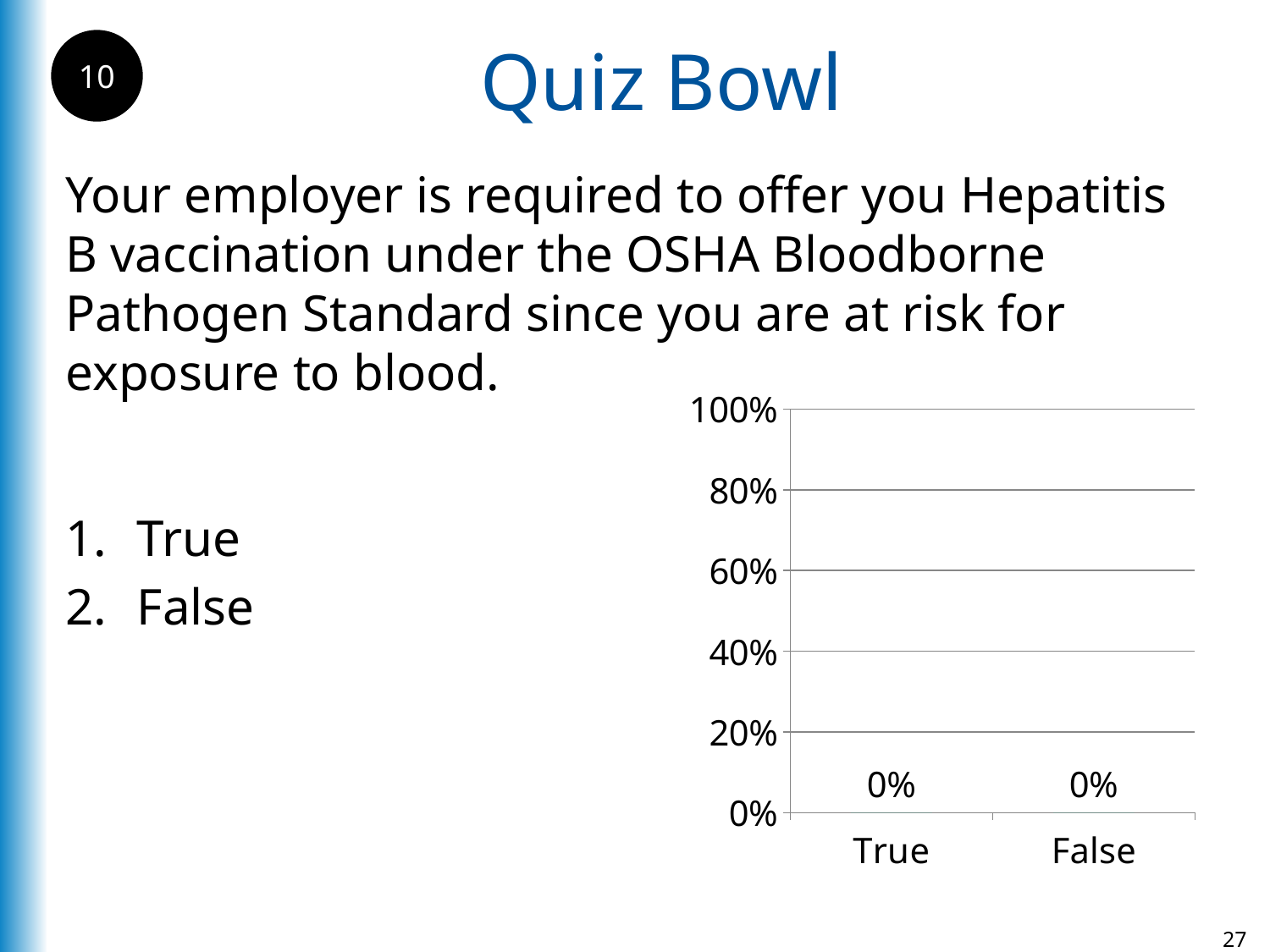
What is the value shown for True? 0% What are the category labels on the x axis of the chart? True, False Is the value for False greater or less than 40%? less What kind of chart is shown on the slide? bar chart What is the difference between the values for True and False? 0% How many categories are shown on the x axis of the chart? 2 What is the highest value labelled on the y axis of the chart? 100% What is the value shown for False? 0% Is the value for True greater or less than 20%? less